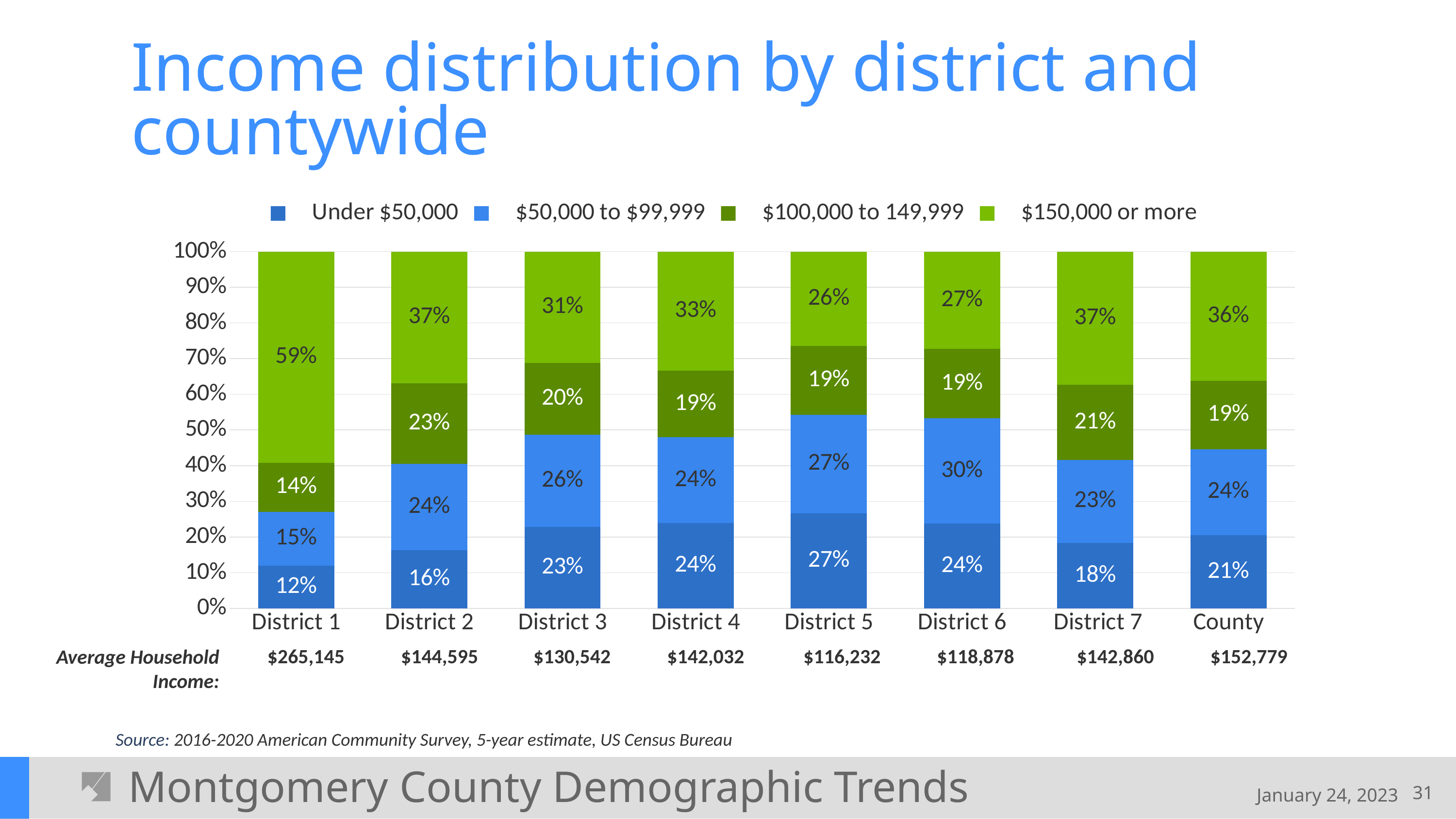
What type of chart is shown on the slide? Stacked bar chart How many categories are shown on the x axis of the chart? 8 What is the value for the $50,000 to $99,999 segment for District 6? 30% Which legend entry is shown in the lightest green colour? $150,000 or more What is the difference between the $150,000 or more share in District 2 and in District 3? 6% How many series does the legend list? 4 Which district has the highest share of households earning $150,000 or more? District 1 What percentage of households in District 5 have income under $50,000? 27% What share of County households fall in the $100,000 to 149,999 range? 19% Which has a larger share of households earning under $50,000, District 3 or District 7? District 3 Which category has the lowest share of households with income under $50,000? District 1 What share of households in District 1 have income of $150,000 or more? 59%